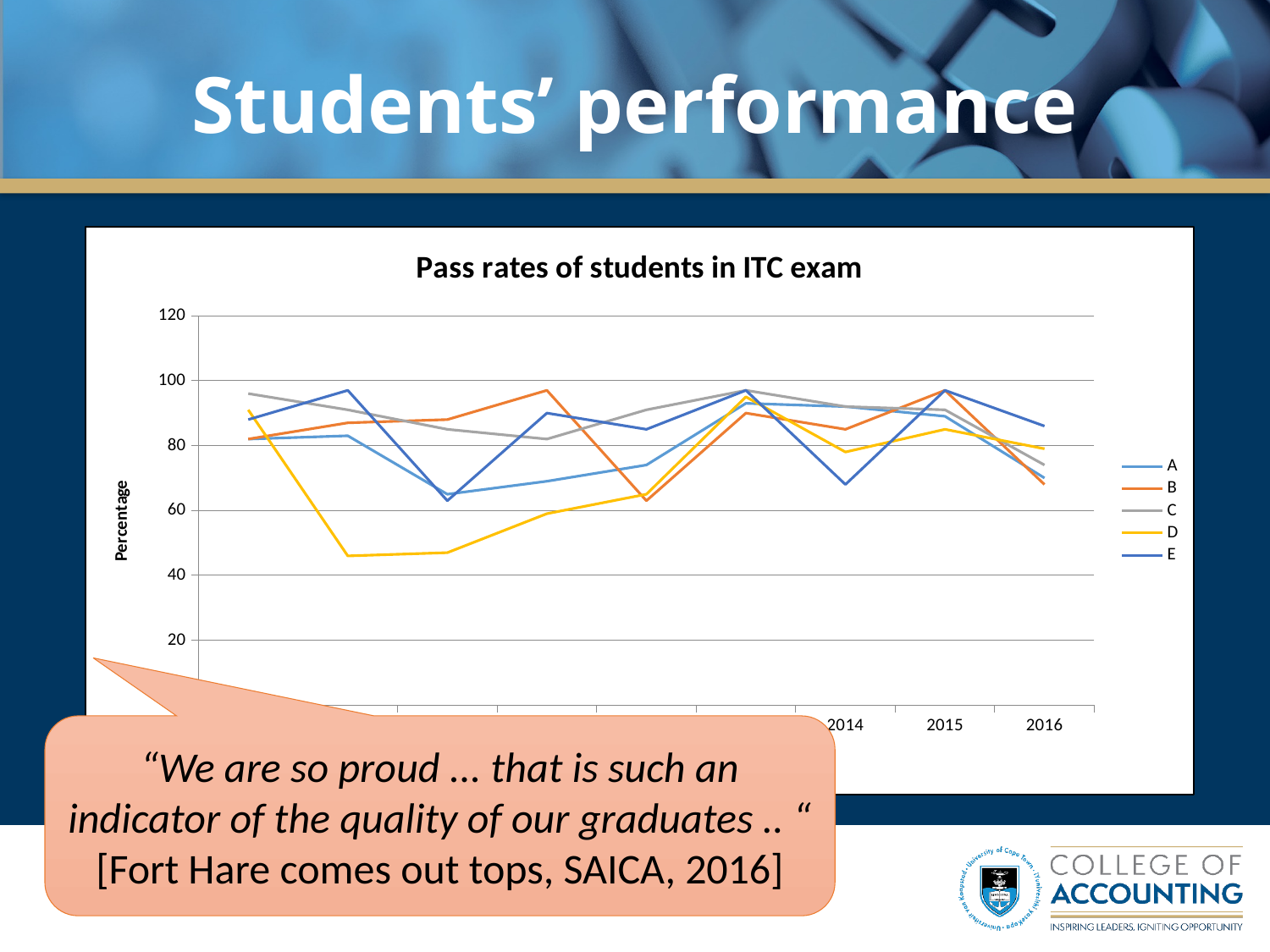
Is the value for series B in 2015 greater or less than 80? greater Which series has the lowest value in 2014? E Is the value for series A in 2014 greater or less than 80? greater Does the value for series E rise or fall from 2014 to 2015? rise Is the value for series E in 2016 greater or less than 80? greater How many series does the legend of the chart list? 5 What is the title of the chart? Pass rates of students in ITC exam What kind of chart is shown on the slide? line chart What is the label on the vertical axis of the chart? Percentage In 2014, which series has a higher value, A or E? A